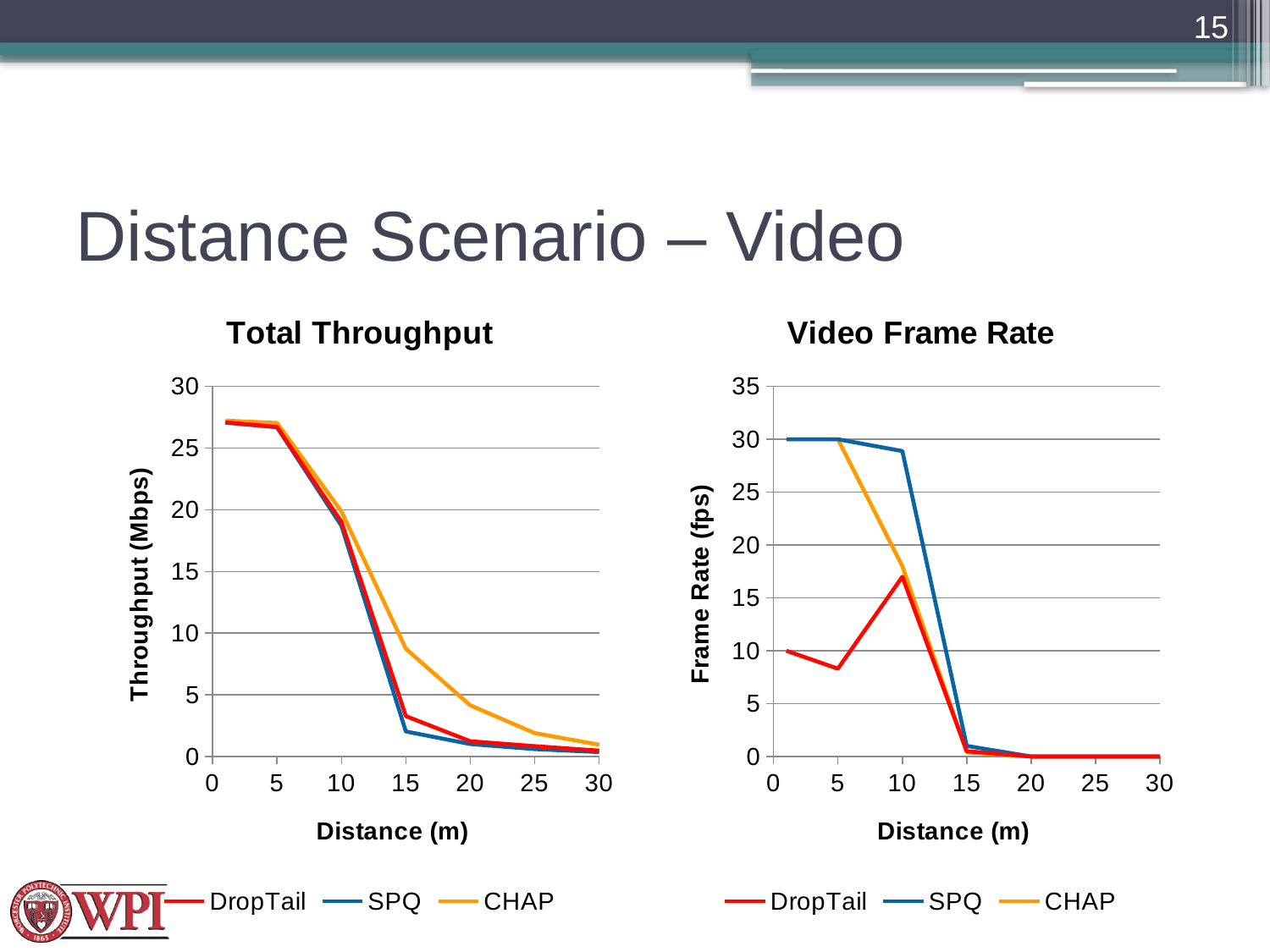
In the Video Frame Rate chart, which series has the lowest frame rate at 5 m? DropTail In the Video Frame Rate chart, which is larger at 5 m, SPQ or DropTail? SPQ In the Total Throughput chart, is the SPQ value at 15 m greater or less than 5? less In the Total Throughput chart, does throughput rise or fall as distance increases? fall What is the x-axis label of the Total Throughput chart? Distance (m) What type of chart is the Total Throughput chart? line chart In the Video Frame Rate chart, is the DropTail value at 5 m greater or less than 10? less How many series does the legend of the Video Frame Rate chart list? 3 In the Total Throughput chart, is the CHAP value at 15 m greater or less than 5? greater What is the y-axis label of the Video Frame Rate chart? Frame Rate (fps) In the Total Throughput chart, which series has the highest throughput at 15 m? CHAP